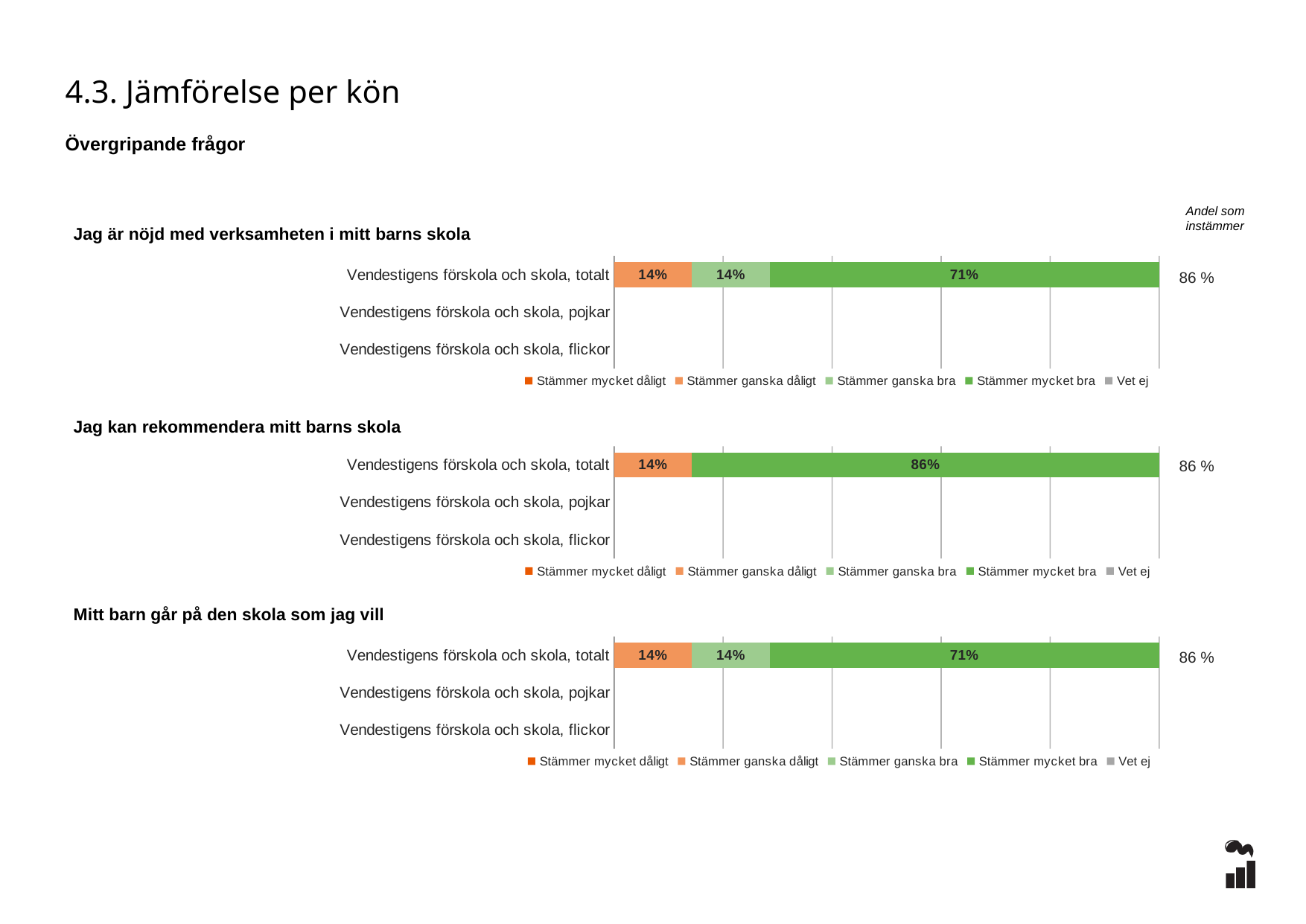
What is the 'Andel som instämmer' value shown next to the 'totalt' bar in the chart 'Jag kan rekommendera mitt barns skola'? 86 % In the chart 'Jag är nöjd med verksamheten i mitt barns skola', which segment of the 'totalt' bar is the largest? Stämmer mycket bra How many series does the legend list in the chart 'Jag kan rekommendera mitt barns skola'? 5 In the chart 'Jag är nöjd med verksamheten i mitt barns skola', what is the value for 'Stämmer mycket bra' for Vendestigens förskola och skola, totalt? 71% In the chart 'Mitt barn går på den skola som jag vill', what is the difference between 'Stämmer mycket bra' and 'Stämmer ganska bra' for the 'totalt' bar? 57% In the chart 'Mitt barn går på den skola som jag vill', what is the value for 'Stämmer ganska dåligt' for Vendestigens förskola och skola, totalt? 14% In the chart 'Jag kan rekommendera mitt barns skola', what is the value for 'Stämmer ganska dåligt' for Vendestigens förskola och skola, totalt? 14% In the chart 'Jag kan rekommendera mitt barns skola', what is the value for 'Stämmer mycket bra' for Vendestigens förskola och skola, totalt? 86% In the chart 'Jag är nöjd med verksamheten i mitt barns skola', which is larger for the 'totalt' bar: 'Stämmer mycket bra' or 'Stämmer ganska bra'? Stämmer mycket bra What kind of chart is 'Jag är nöjd med verksamheten i mitt barns skola'? Stacked bar chart How many categories are shown on the y axis of the chart 'Mitt barn går på den skola som jag vill'? 3 In the chart 'Jag kan rekommendera mitt barns skola', what is the difference between 'Stämmer mycket bra' and 'Stämmer ganska dåligt' for the 'totalt' bar? 72%